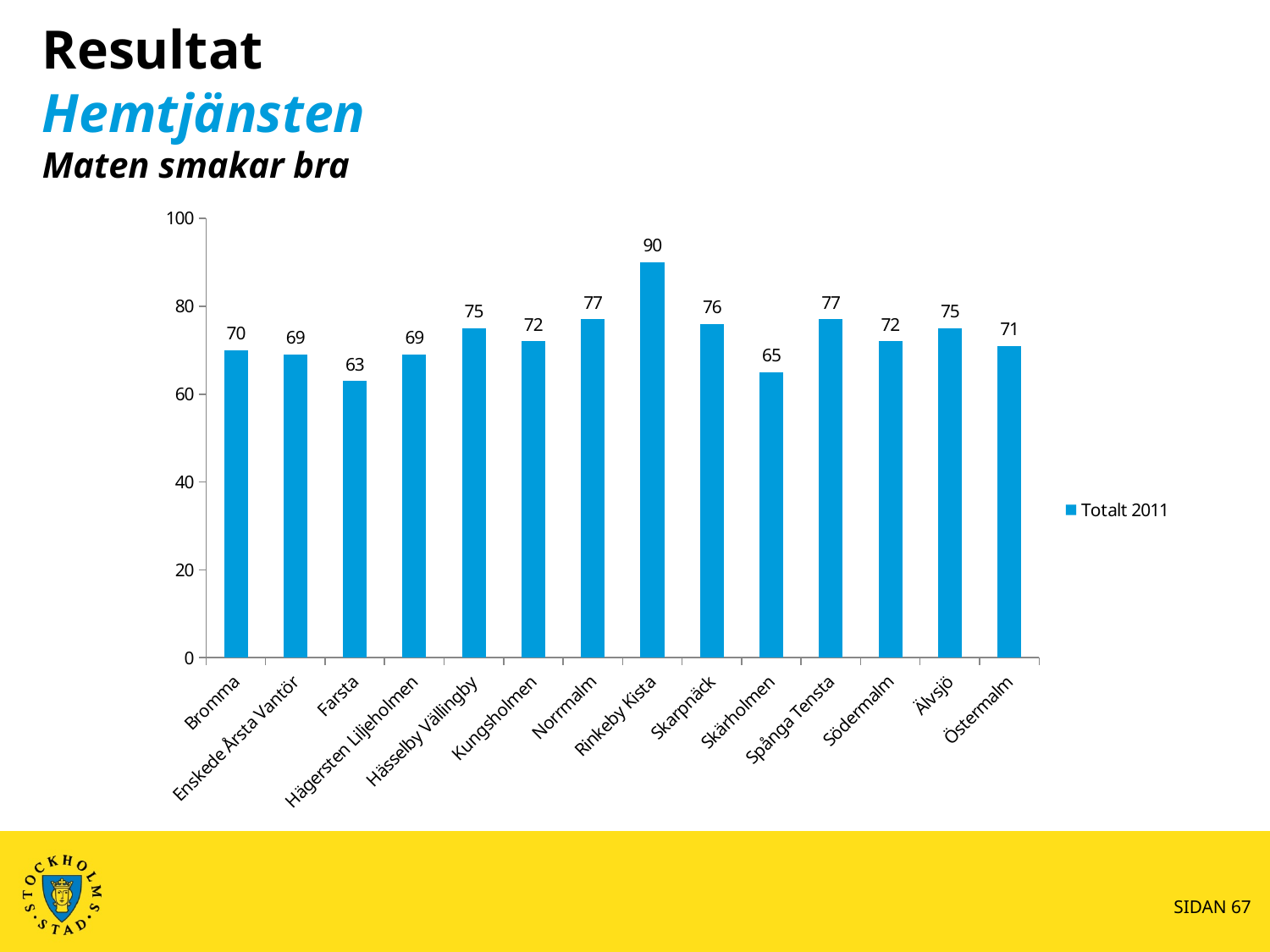
What is the difference between the values for Rinkeby Kista and Farsta? 27 How many series does the legend list? 1 Which category has the highest value? Rinkeby Kista Which category has the lowest value? Farsta What is the value for Farsta? 63 What is the value for Skärholmen? 65 What kind of chart is shown on the slide? bar chart What is the difference between the values for Norrmalm and Bromma? 7 Is the value for Rinkeby Kista greater or less than 80? greater How many categories are shown on the x axis? 14 What is the value for Rinkeby Kista? 90 Which is larger, the value for Skarpnäck or the value for Östermalm? Skarpnäck